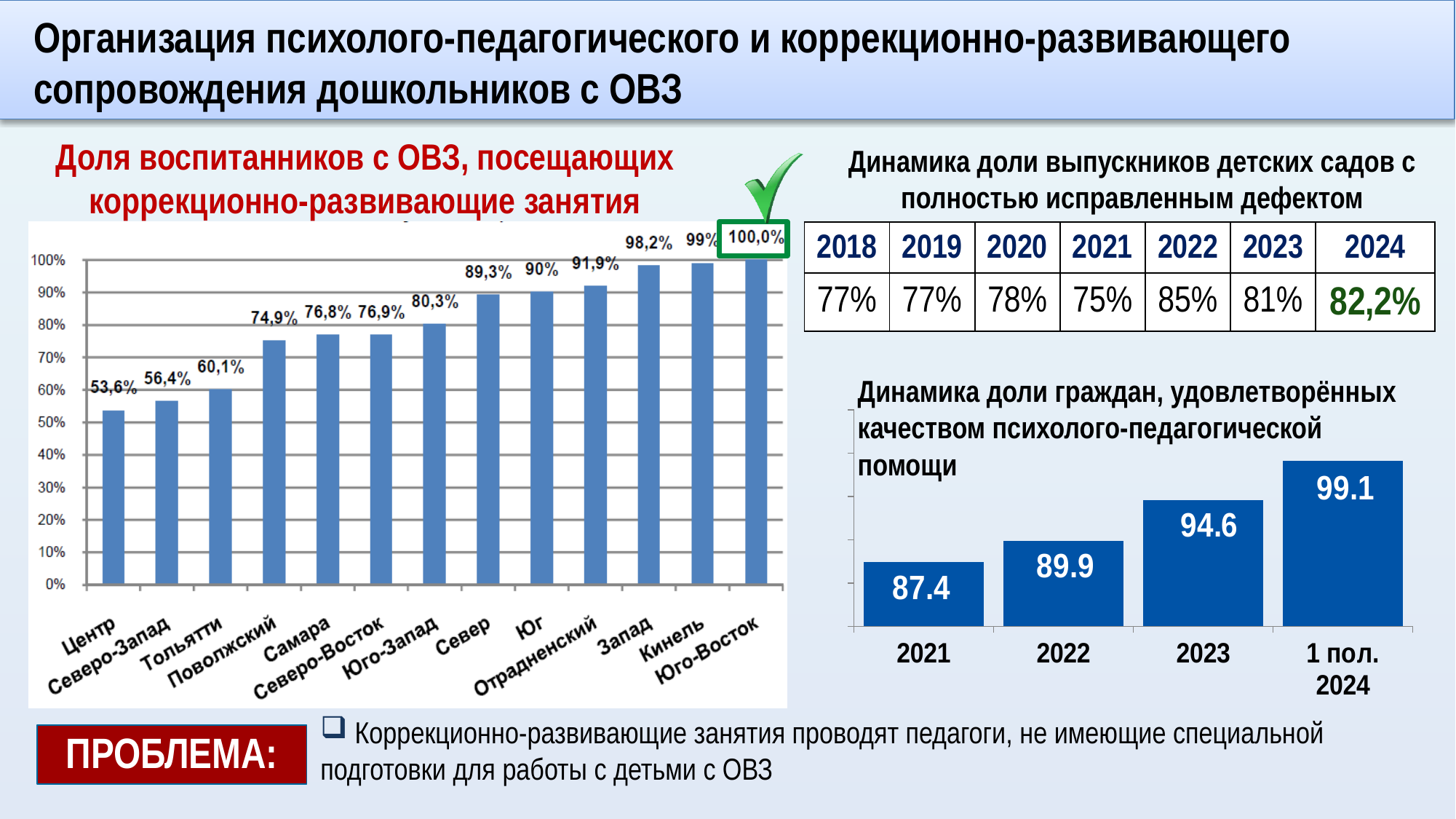
In the left chart 'Доля воспитанников с ОВЗ, посещающих коррекционно-развивающие занятия', what is the value for Тольятти? 60,1% In the left chart 'Доля воспитанников с ОВЗ, посещающих коррекционно-развивающие занятия', what is the difference between the values for Запад and Центр? 44,6% In the left chart 'Доля воспитанников с ОВЗ, посещающих коррекционно-развивающие занятия', which is larger: the value for Поволжский or the value for Юго-Запад? Юго-Запад In the left chart 'Доля воспитанников с ОВЗ, посещающих коррекционно-развивающие занятия', what is the value for Север? 89,3% In the left chart 'Доля воспитанников с ОВЗ, посещающих коррекционно-развивающие занятия', how many categories are shown on the x axis? 13 In the right chart 'Динамика доли граждан, удовлетворённых качеством психолого-педагогической помощи', what is the value for 1 пол. 2024? 99.1 In the right chart 'Динамика доли граждан, удовлетворённых качеством психолого-педагогической помощи', do the values rise or fall from 2021 to 1 пол. 2024? Rise What kind of chart is the left chart 'Доля воспитанников с ОВЗ, посещающих коррекционно-развивающие занятия'? Bar chart In the left chart 'Доля воспитанников с ОВЗ, посещающих коррекционно-развивающие занятия', which category has the lowest value? Центр In the left chart 'Доля воспитанников с ОВЗ, посещающих коррекционно-развивающие занятия', which category has the highest value? Юго-Восток In the right chart 'Динамика доли граждан, удовлетворённых качеством психолого-педагогической помощи', what is the value for 2022? 89.9 In the right chart 'Динамика доли граждан, удовлетворённых качеством психолого-педагогической помощи', what is the difference between the values for 2023 and 2021? 7.2